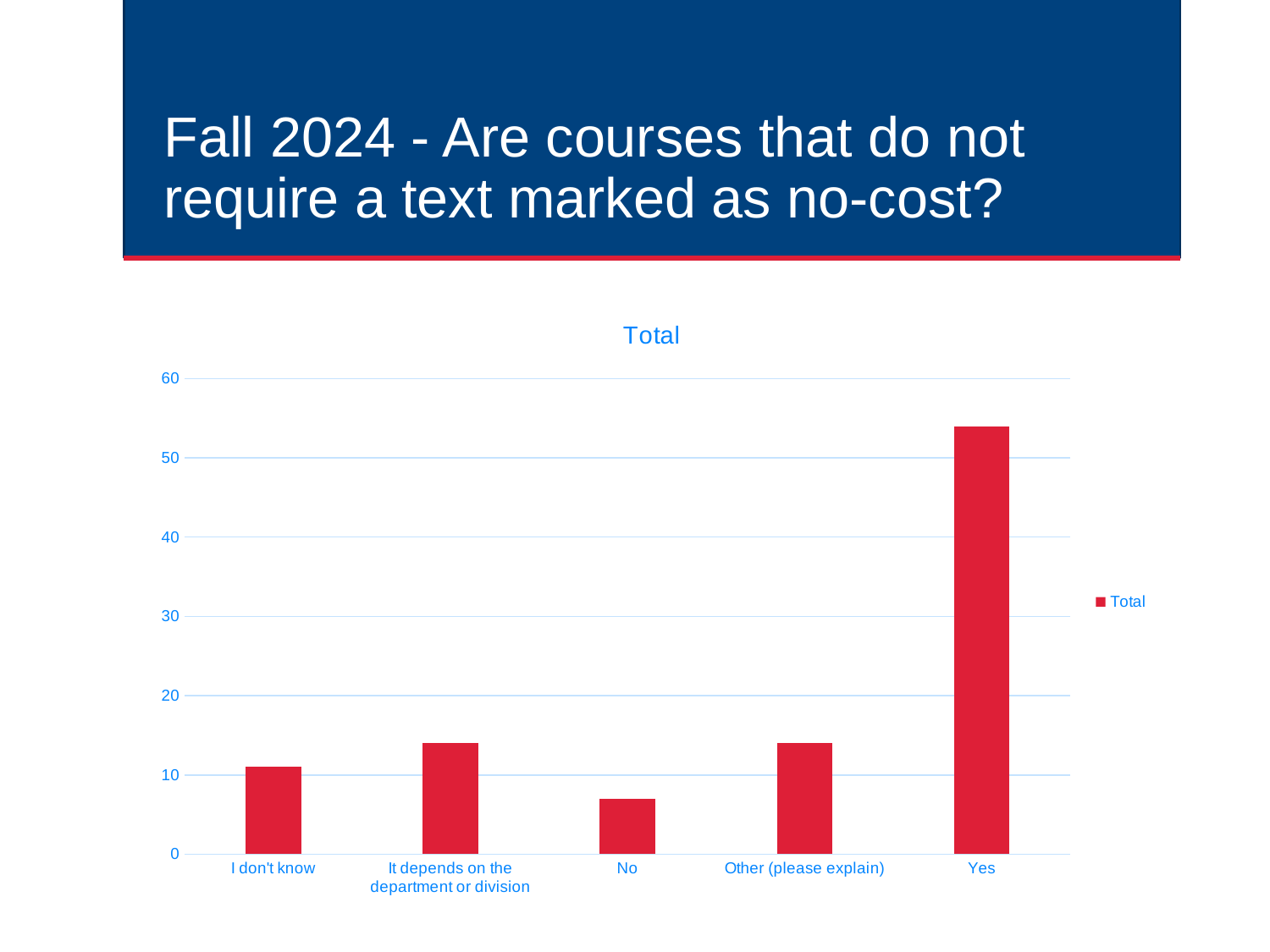
How many categories are shown on the x axis of the chart? 5 Which is larger, the value for Yes or the value for No? Yes Is the value for No greater or less than 10? less How many series does the legend list? 1 Which category has the lowest value? No Which category has the highest value? Yes What kind of chart is shown on the slide? bar chart Is the value for Other (please explain) greater or less than 20? less Which is larger, the value for I don't know or the value for No? I don't know What is the title of the chart? Total Is the value for Yes greater or less than 50? greater